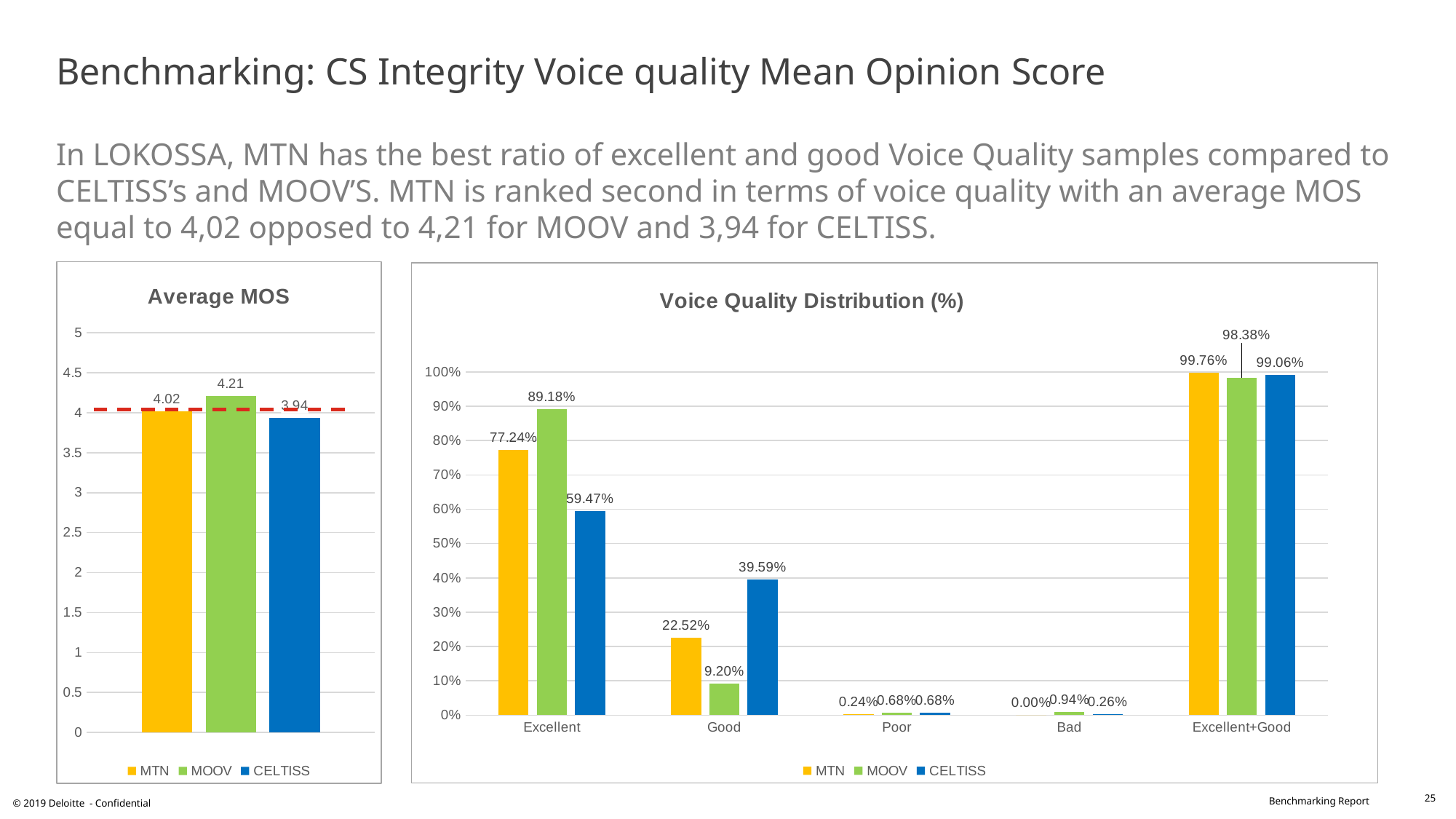
In the Average MOS chart, which operator has the lowest average MOS? CELTISS In the Voice Quality Distribution (%) chart, what is the CELTISS value for Excellent? 59.47% In the Average MOS chart, what is the difference between the MOOV and MTN values? 0.19 In the Voice Quality Distribution (%) chart, what is the MOOV value for Bad? 0.94% In the Voice Quality Distribution (%) chart, what is the MTN value for Good? 22.52% In the Average MOS chart, how many series does the legend list? 3 What kind of chart is the Voice Quality Distribution (%) chart? Bar chart In the Voice Quality Distribution (%) chart, how many categories are shown on the x axis? 5 In the Voice Quality Distribution (%) chart, what is the difference between the MTN and MOOV values for Excellent+Good? 1.38% In the Average MOS chart, what is the value for MOOV? 4.21 In the Voice Quality Distribution (%) chart, which operator has the highest value for Excellent? MOOV In the Voice Quality Distribution (%) chart, which is larger for Good: MOOV or CELTISS? CELTISS